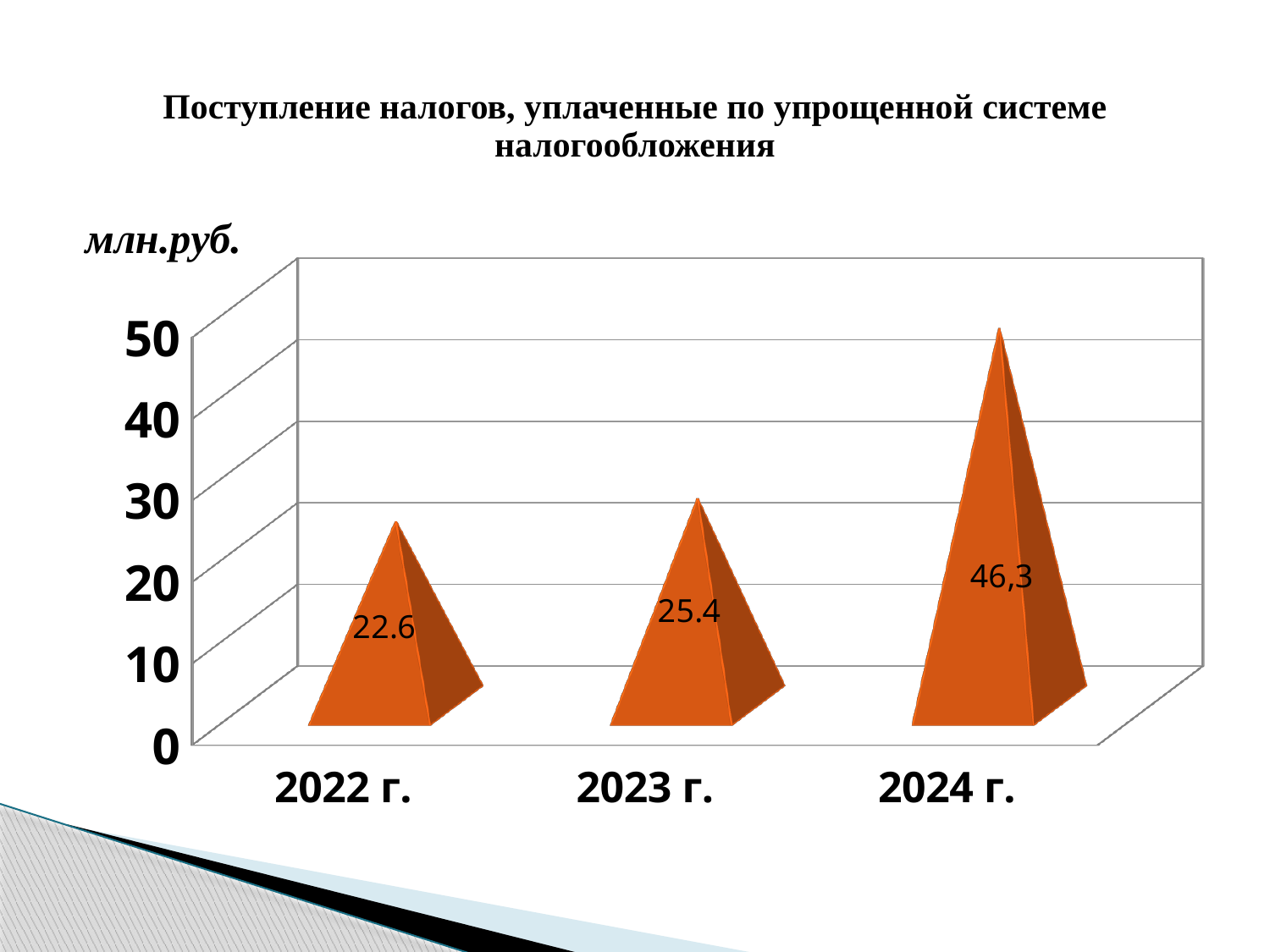
Which year has the lowest value? 2022 г. What is the difference between the values for 2024 г. and 2023 г.? 20.9 What kind of chart is shown on the slide? bar chart What is the value for 2023 г.? 25.4 Do the values rise or fall from 2022 г. to 2024 г.? rise Which year has the highest value? 2024 г. How many years are shown on the chart? 3 What is the difference between the values for 2023 г. and 2022 г.? 2.8 What is the value for 2024 г.? 46,3 Is the value for 2024 г. greater or less than 40? greater Which is larger, the value for 2024 г. or the value for 2022 г.? 2024 г. What is the value for 2022 г.? 22.6